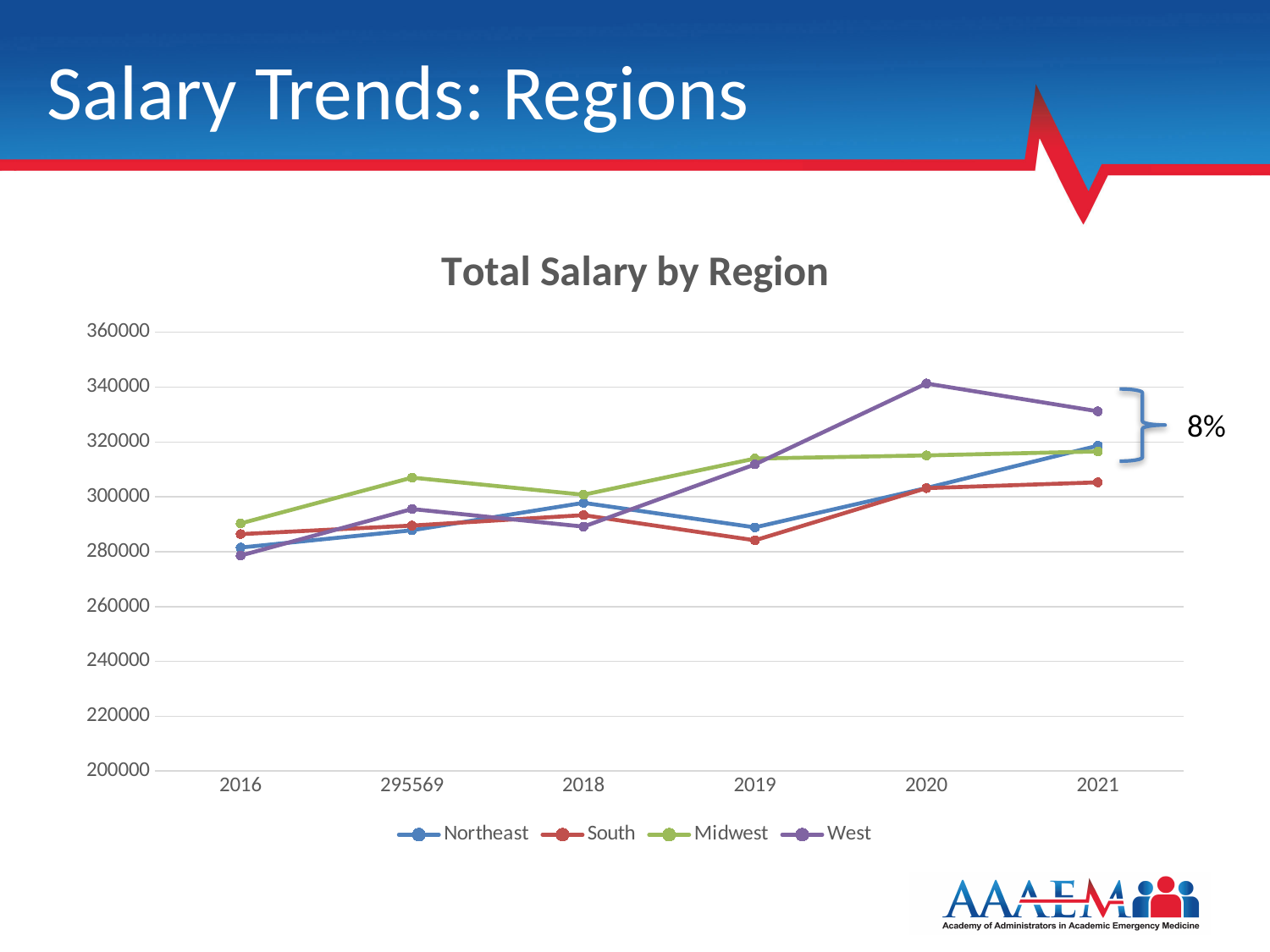
Which region has the highest total salary in 2020? West Which region has the lowest total salary in 2019? South Is the value for West in 2020 greater or less than 320000? greater How many points are plotted along the x axis for each region? 6 Which region has the lowest total salary in 2021? South What percentage is shown in the annotation next to the bracket on the right of the chart? 8% Does the West line rise or fall from 2016 to 2020? rise In 2021, which is larger: the value for West or the value for South? West How many series does the legend list? 4 What kind of chart is shown on the slide? line chart Is the value for Midwest in 2016 greater or less than 300000? less Is the value for South in 2021 greater or less than 300000? greater